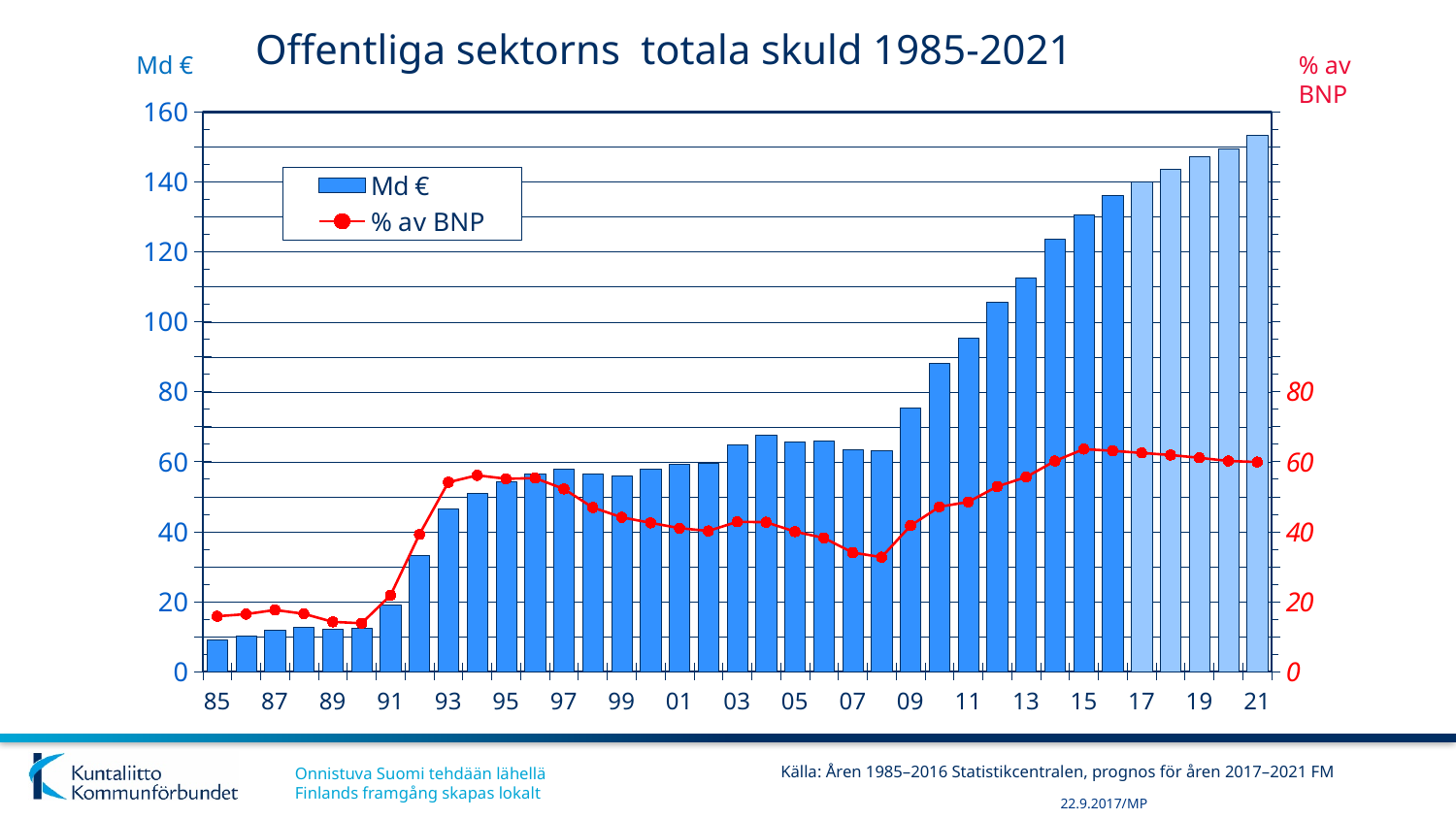
How many series does the legend list? 2 What are the two series named in the legend? Md € and % av BNP How many years (bars) are plotted on the x axis? 37 Is the Md € value for 2009 greater or less than 80? less What is the title of the chart? Offentliga sektorns totala skuld 1985-2021 Which year has the larger Md € bar, 2005 or 2010? 2010 Which year has the lowest Md € bar? 1985 (85) Is the % av BNP value for 2008 greater or less than 40? less Do the Md € bars rise or fall from 2009 to 2021? rise Is the Md € value for 2021 greater or less than 140? greater Which year has the highest Md € bar? 2021 (21) What kind of chart is shown on the slide? A bar chart combined with a line chart